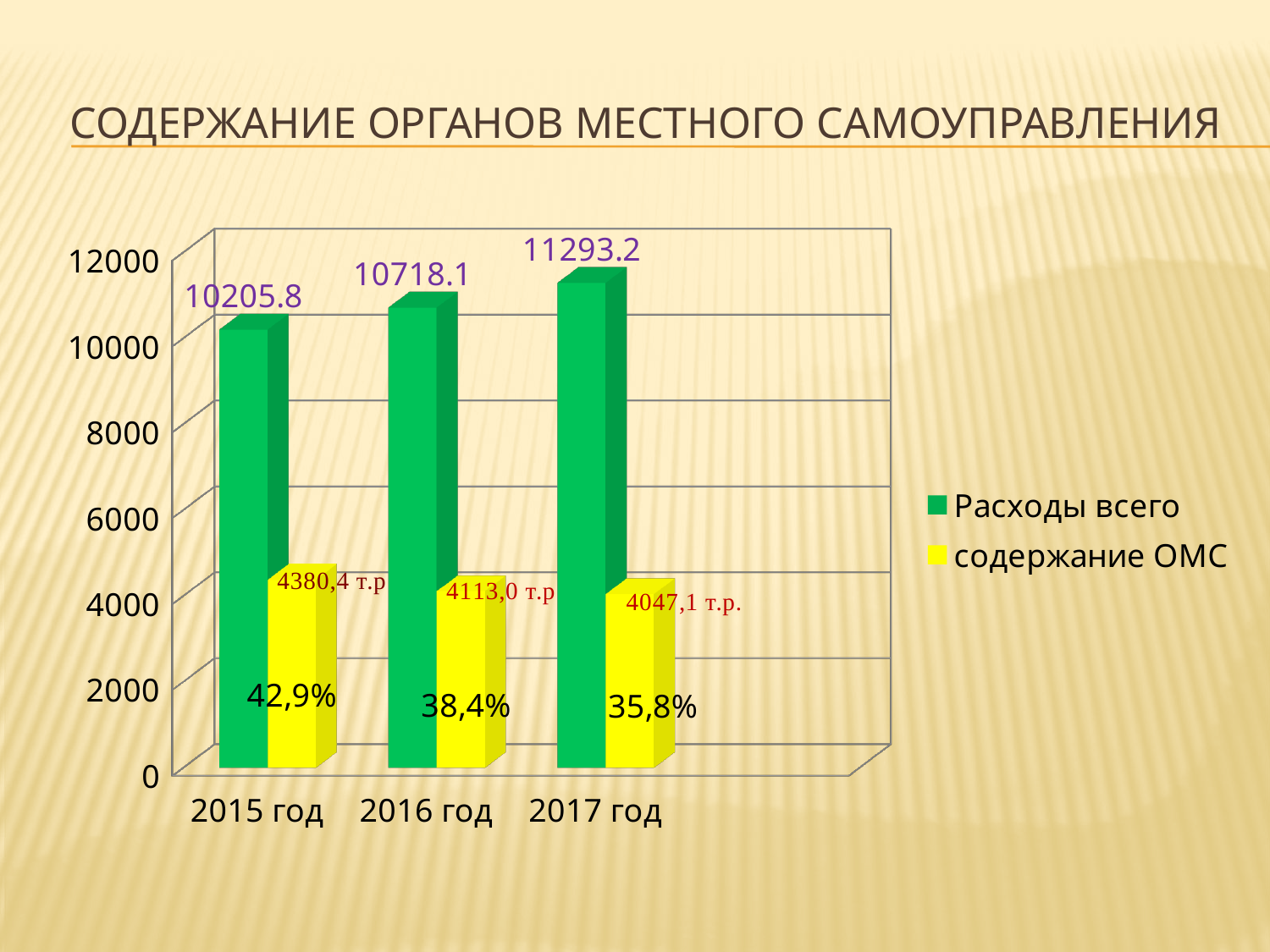
What percentage is shown for 2015 год? 42,9% Which year has the highest value for Расходы всего? 2017 год What type of chart is shown on the slide? bar chart Do the values for Расходы всего rise or fall from 2015 год to 2017 год? rise What is the value of Расходы всего for 2017 год? 11293.2 What is the value of Расходы всего for 2015 год? 10205.8 What is the difference between Расходы всего in 2017 год and 2016 год? 575.1 Which year has the lowest labelled value for содержание ОМС? 2017 год Which is larger: содержание ОМС in 2015 год or in 2017 год? 2015 год How many series does the legend list? 2 How many years are shown on the x axis? 3 What is the labelled value of содержание ОМС for 2016 год? 4113,0 т.р